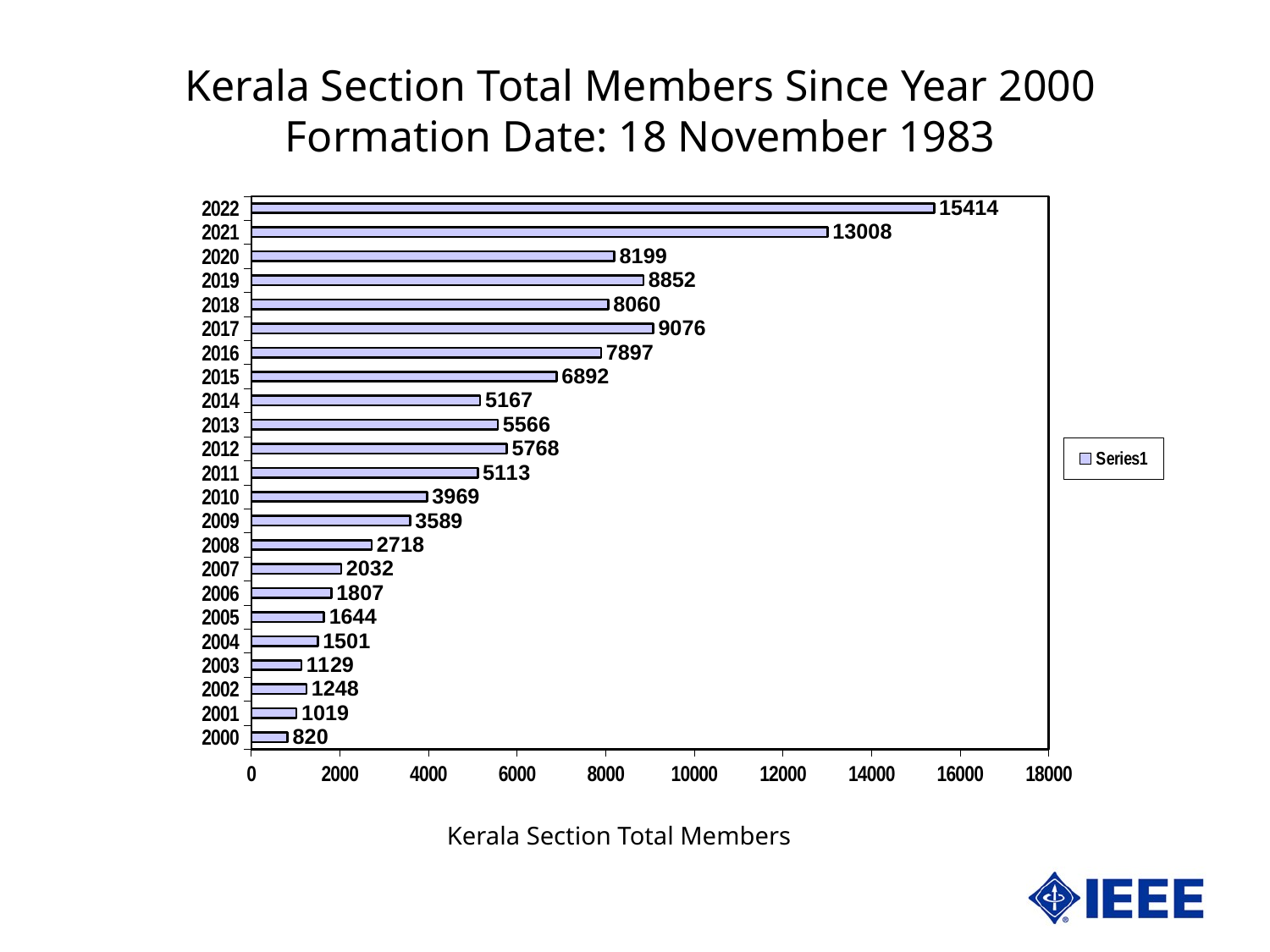
What is the value for 2000? 820 Which year has the highest value? 2022 What is the value for 2022? 15414 Which year has the lowest value? 2000 How many series does the legend list? 1 What is the difference between the values for 2022 and 2021? 2406 Is the value for 2017 greater or less than 8000? greater What is the value for 2015? 6892 Which is larger, the value for 2019 or the value for 2020? 2019 What is the name of the series in the legend? Series1 What kind of chart is shown? bar chart How many years are shown on the chart? 23